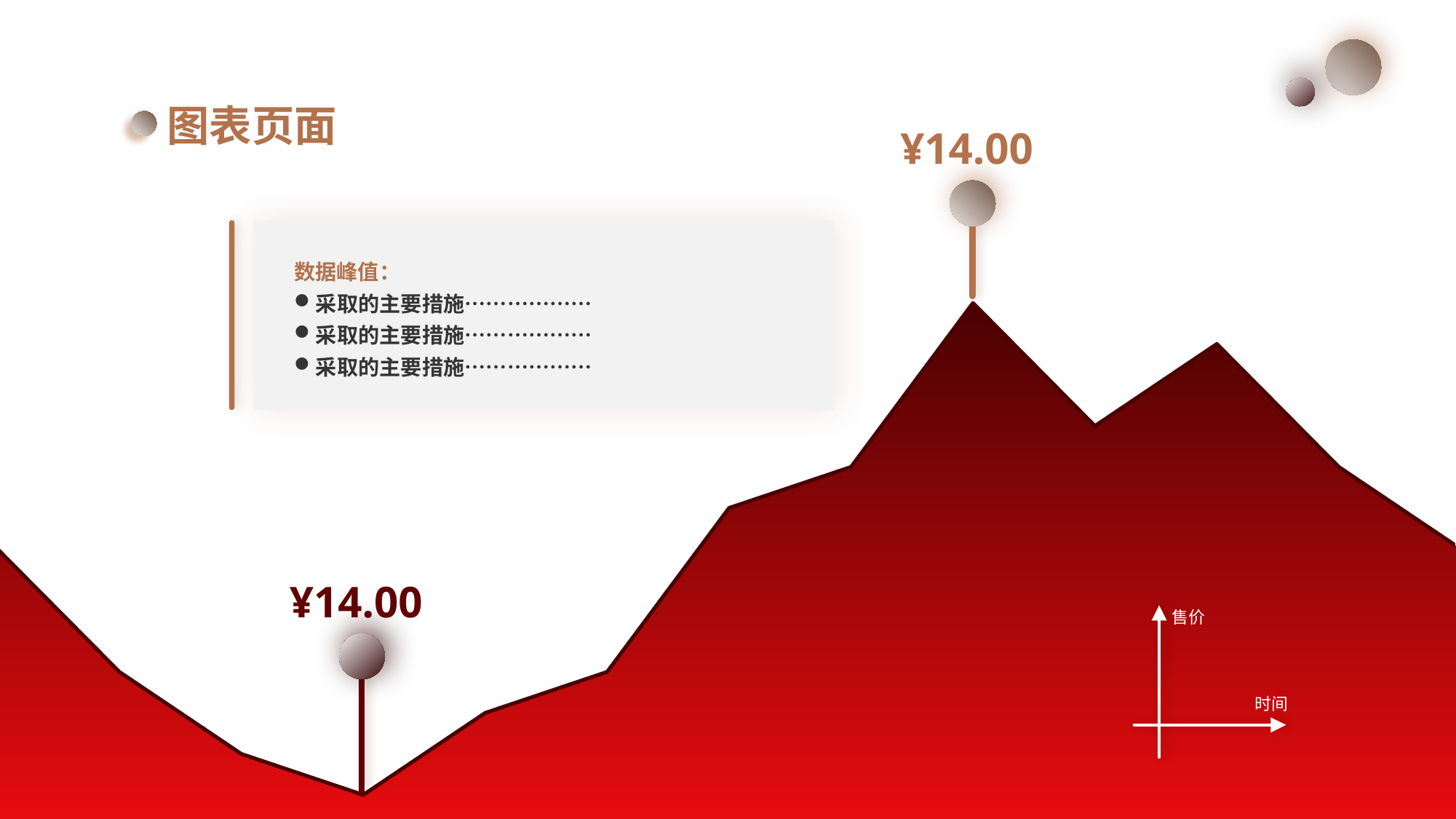
What is the label on the horizontal axis of the chart? 时间 What value is labeled at the low point on the left side of the chart? ¥14.00 What kind of chart is shown on the slide? area chart What value is labeled at the highest peak of the chart? ¥14.00 How many data points on the chart have a printed value label? 2 What is the label on the vertical axis of the chart? 售价